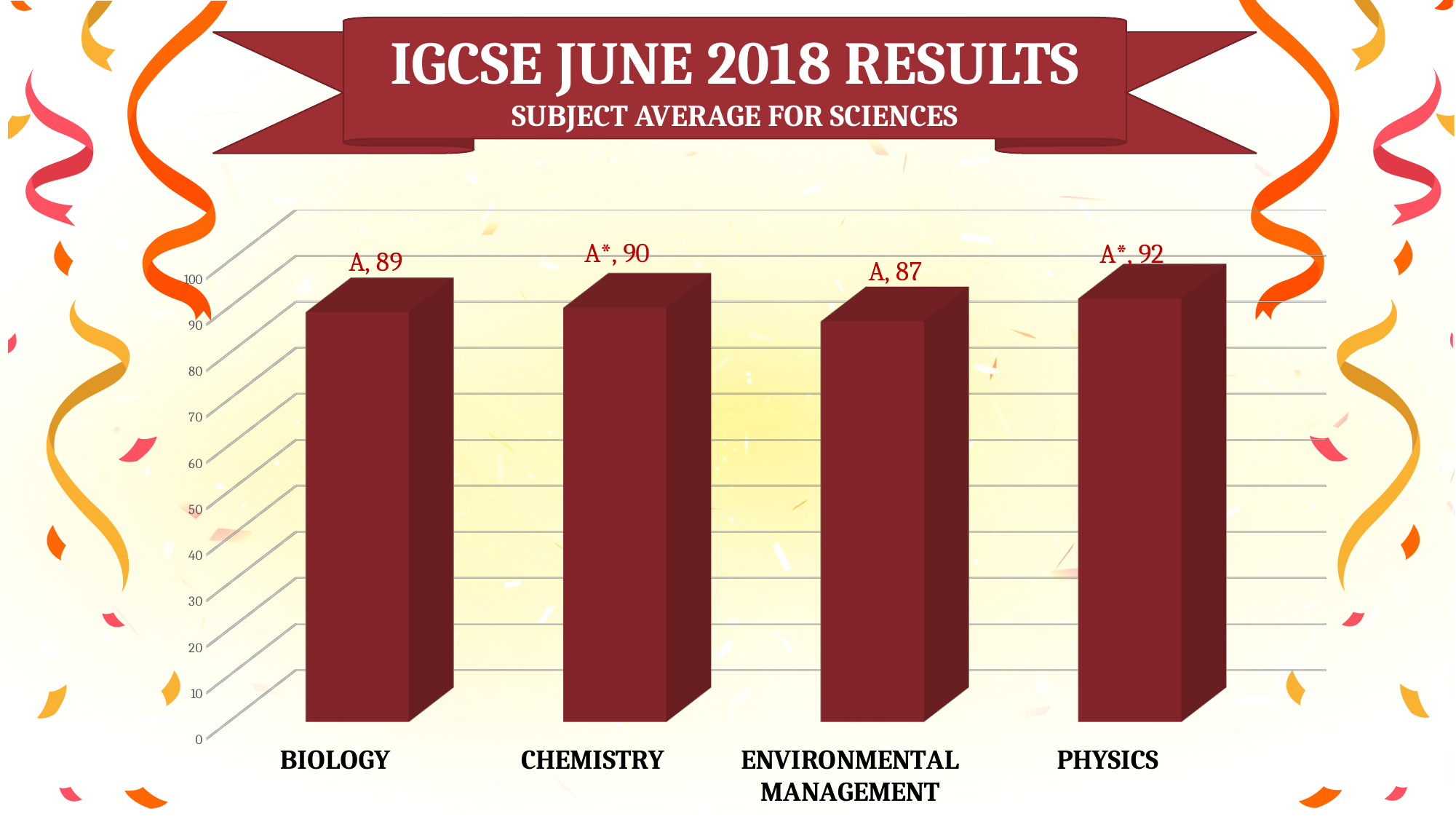
Which subject has the lowest average? Environmental Management What is the subject average for Environmental Management? 87 Is the value for Environmental Management greater or less than 80? greater What kind of chart is shown on the slide? Bar chart What is the subject average for Biology? 89 How many subjects are shown in the chart? 4 What is the subject average for Chemistry? 90 Which subject has the highest average? Physics What is the difference between the Physics average and the Environmental Management average? 5 What is the subject average for Physics? 92 Which has a higher average, Biology or Chemistry? Chemistry What grade label is shown above the Physics bar? A*